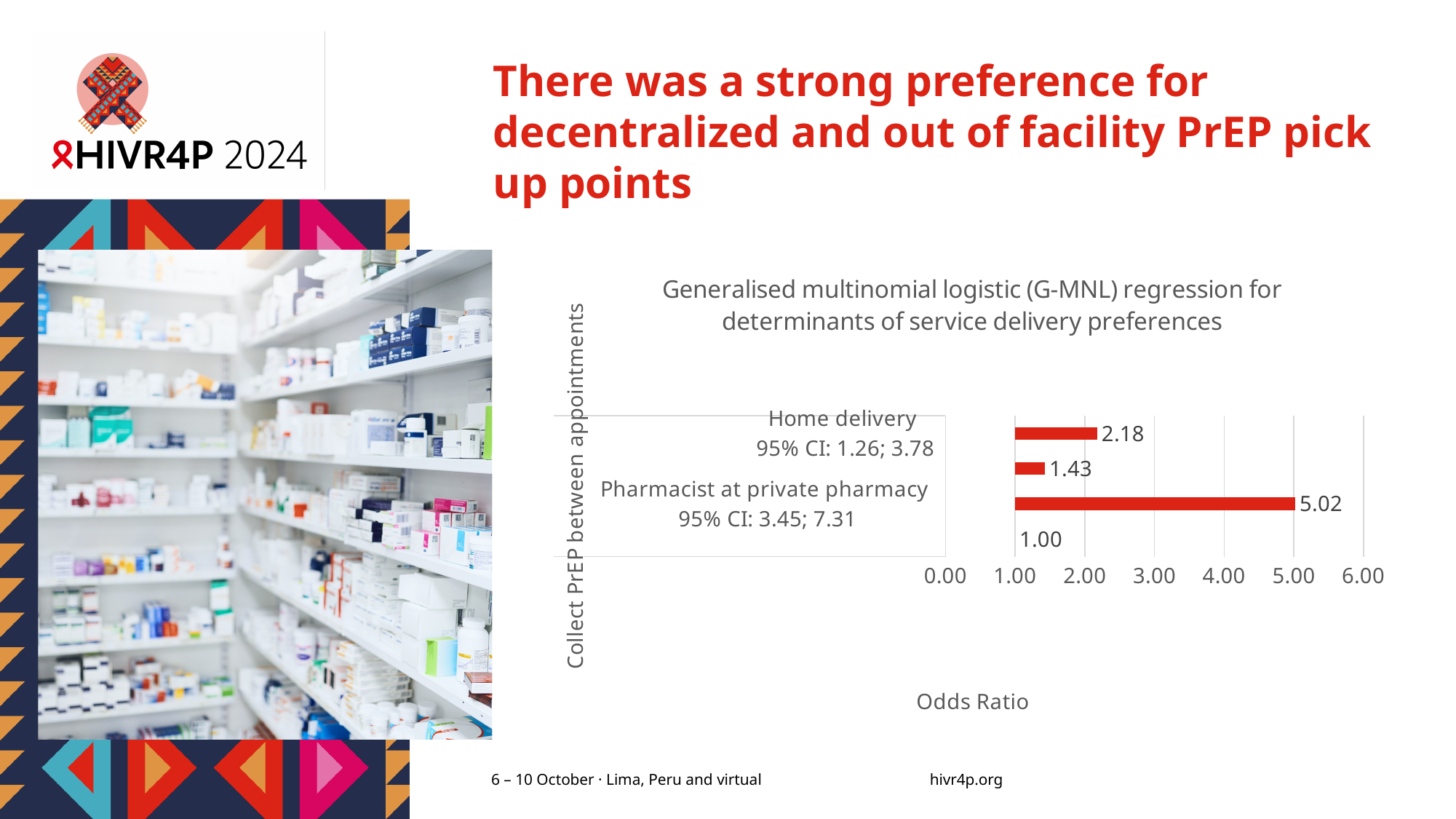
What type of chart is shown on the slide? Bar chart What 95% CI is shown for Pharmacist at private pharmacy? 3.45; 7.31 What is the difference between the largest labelled value (5.02) and the second largest (2.18)? 2.84 Which is larger, the value of the top bar (2.18) or the second bar from the top (1.43)? The top bar (2.18) Is the longest bar's value greater or less than 4.00? greater What 95% CI is shown for Home delivery? 1.26; 3.78 What is the smallest value labelled on the chart? 1.00 What is the title of the chart? Generalised multinomial logistic (G-MNL) regression for determinants of service delivery preferences What is the difference between the values 2.18 and 1.43 shown on the chart? 0.75 What is the largest odds ratio value labelled on the chart? 5.02 What is the title of the x axis? Odds Ratio